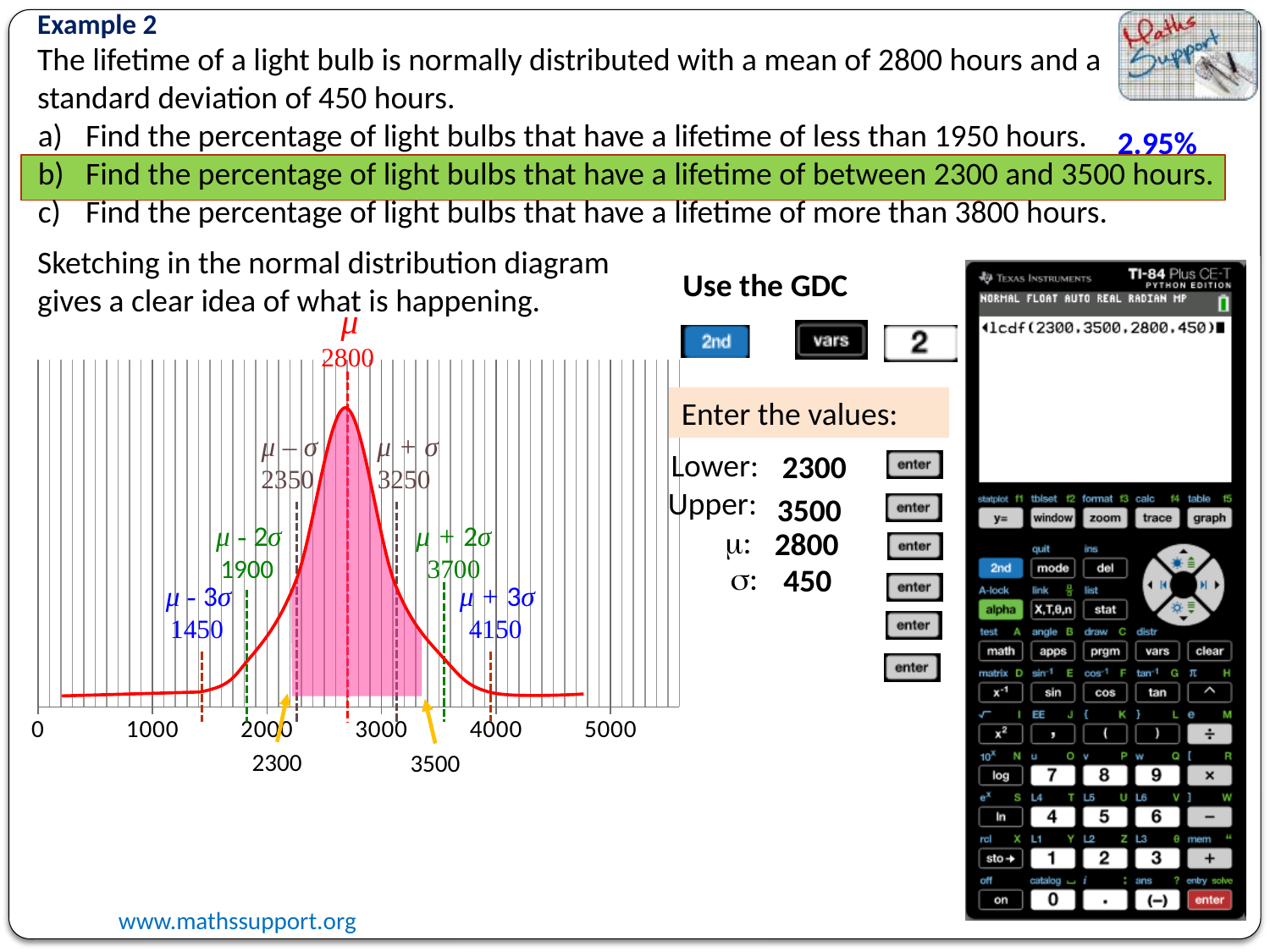
How many numbered tick labels are shown on the x axis of the normal distribution diagram? 6 What is the lower boundary value of the shaded region on the normal distribution diagram? 2300 What is the upper boundary value of the shaded region on the normal distribution diagram? 3500 What colour is the shaded region under the curve on the normal distribution diagram? pink What is the difference between the values labelled at μ + σ and μ - σ on the diagram? 900 What value is labelled at μ + 3σ on the normal distribution diagram? 4150 What kind of chart is the normal distribution diagram on the slide? line chart What value is labelled at the mean μ on the normal distribution diagram? 2800 What is the difference between the upper and lower boundaries of the shaded region on the diagram? 1200 What value is labelled at μ - 2σ on the normal distribution diagram? 1900 Which is larger on the diagram, the value at μ + 2σ or the value at μ + σ? μ + 2σ What value is labelled at μ + σ on the normal distribution diagram? 3250